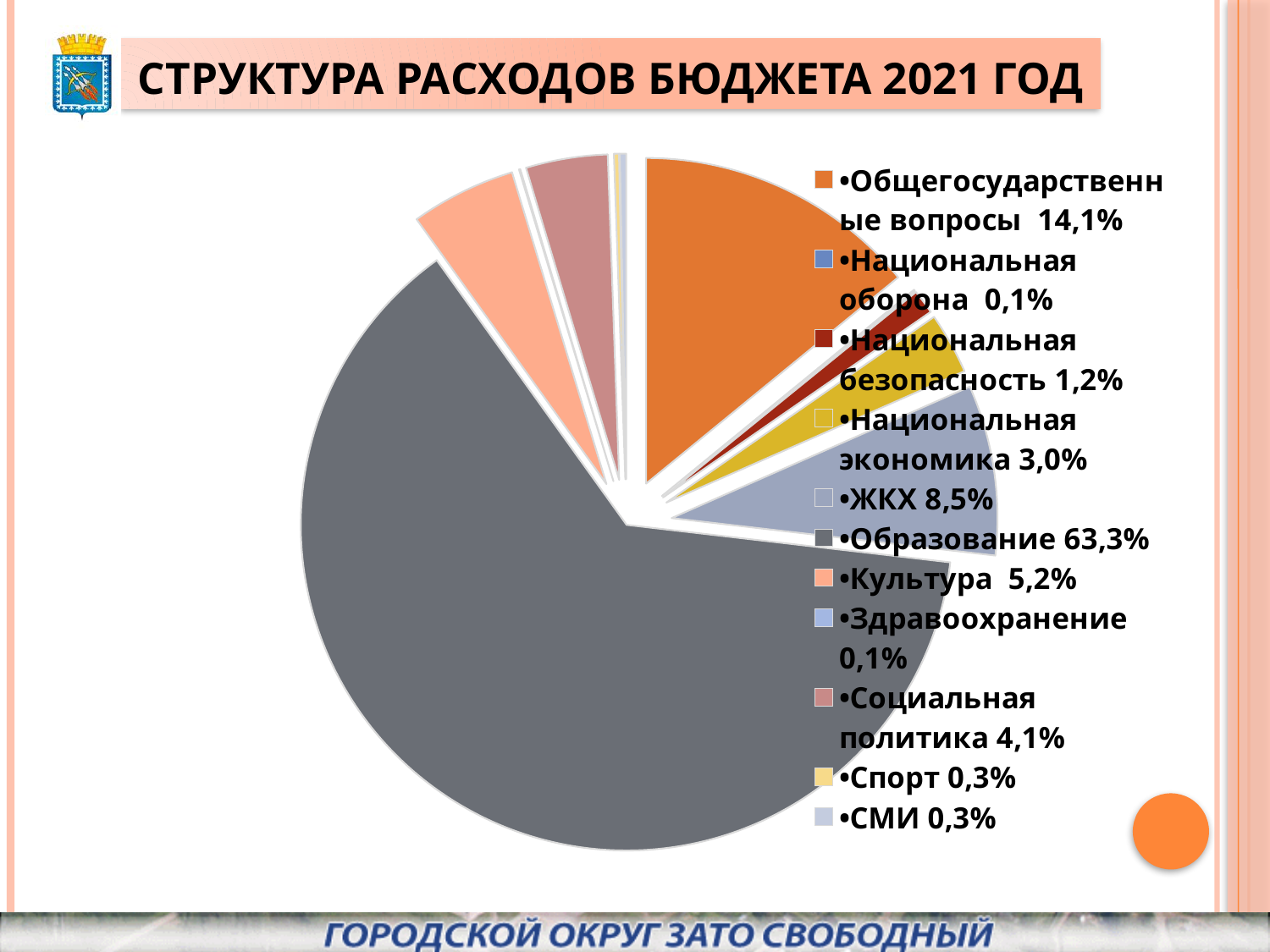
Which category has the largest share of the pie? Образование What kind of chart is shown on the slide? pie chart What is the title of the chart on the slide? СТРУКТУРА РАСХОДОВ БЮДЖЕТА 2021 ГОД What colour is the slice for Образование? dark grey What is the value for Социальная политика? 4,1% What is the value for Общегосударственные вопросы? 14,1% What is the value for Национальная безопасность? 1,2% Which is larger, ЖКХ or Культура? ЖКХ How many categories does the pie chart have? 11 What is the difference between the shares of Образование and Общегосударственные вопросы? 49,2% What share of the budget expenditure goes to Образование? 63,3% What is the value for ЖКХ? 8,5%